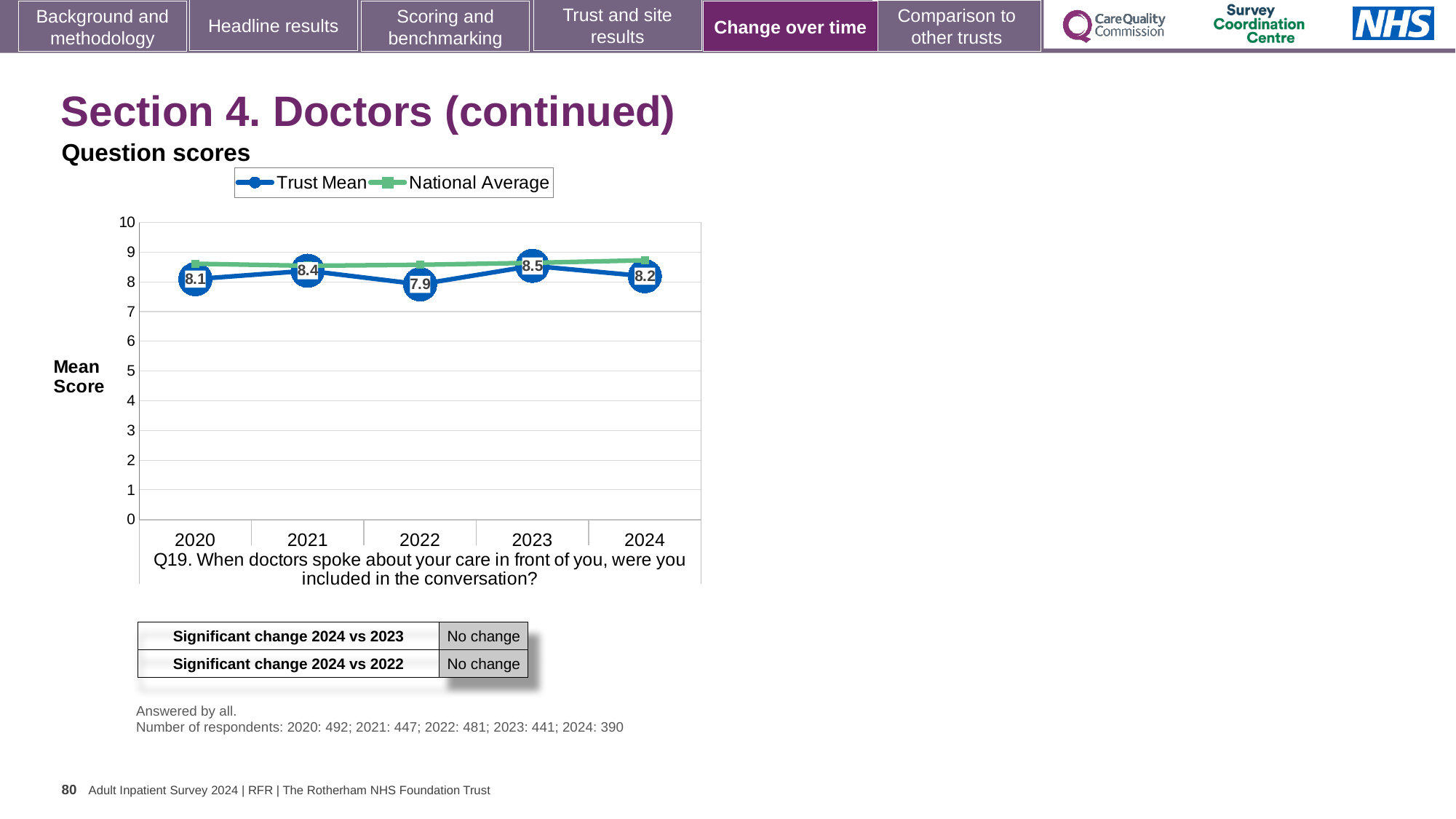
How many years are shown on the x axis? 5 What is the Trust Mean score for 2022? 7.9 In which year is the Trust Mean score lowest? 2022 What is the Trust Mean score for 2024? 8.2 In which year is the Trust Mean score highest? 2023 Which year has the larger Trust Mean score, 2020 or 2021? 2021 What kind of chart is shown on the slide? Line chart Does the Trust Mean score rise or fall from 2023 to 2024? Fall What is the label on the y axis of the chart? Mean Score What is the difference between the Trust Mean scores for 2023 and 2022? 0.6 Is the National Average value for 2024 greater or less than 8? greater How many series does the legend list? 2